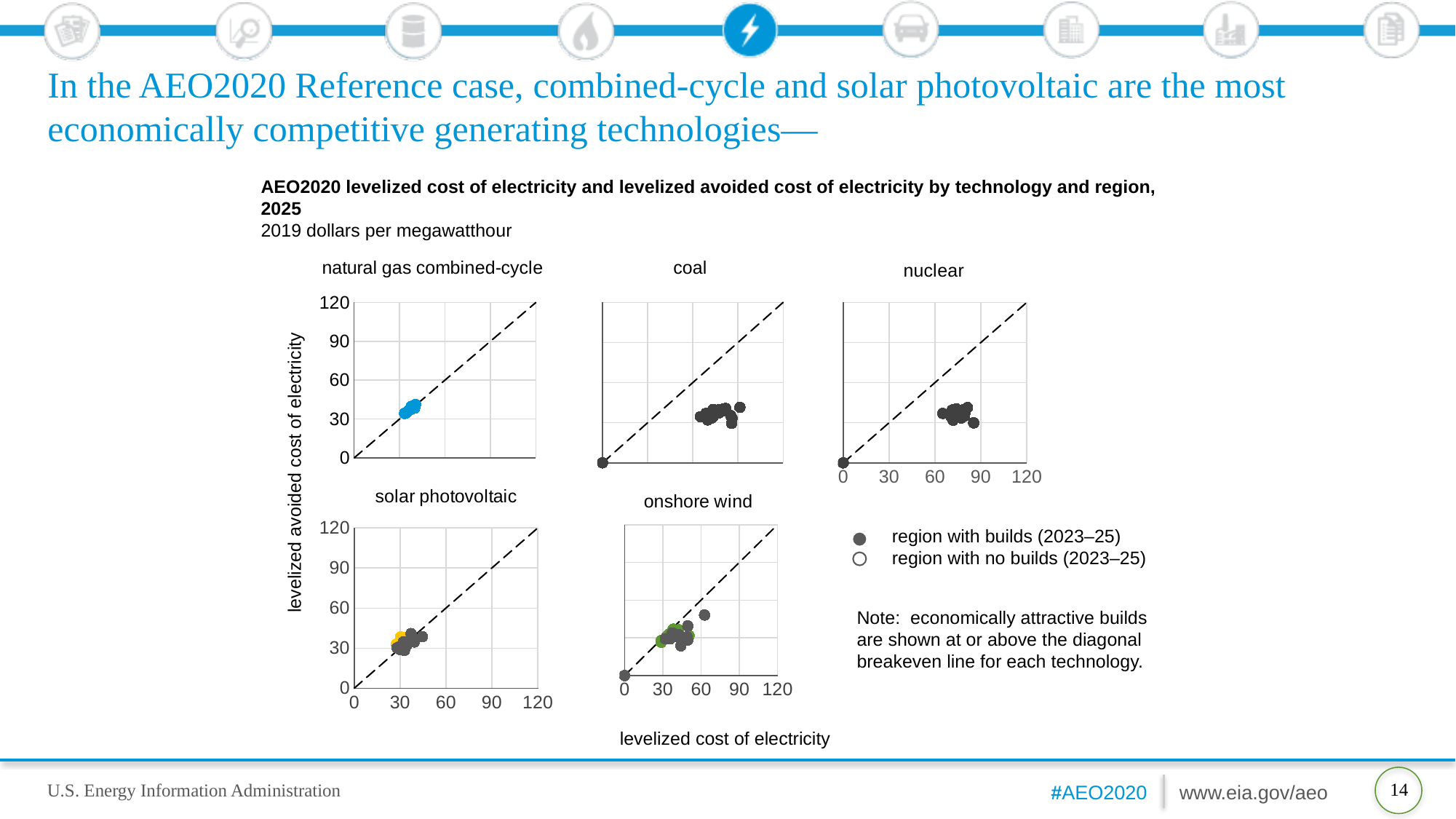
In the 'coal' chart, are the levelized cost of electricity values for the plotted regions greater or less than 60? greater In the 'nuclear' chart, are the levelized cost of electricity values for the plotted regions greater or less than 60? greater In the 'solar photovoltaic' chart, are the levelized avoided cost of electricity values for the plotted regions greater or less than 60? less What is the maximum value shown on the x axis of the 'solar photovoltaic' chart? 120 How many technology panels (charts) are shown on the slide? 5 What does a filled circle represent according to the legend? region with builds (2023–25) What kind of chart is used in the 'natural gas combined-cycle' panel? scatter chart What unit is given for the values in the charts? 2019 dollars per megawatthour How many entries does the legend list? 2